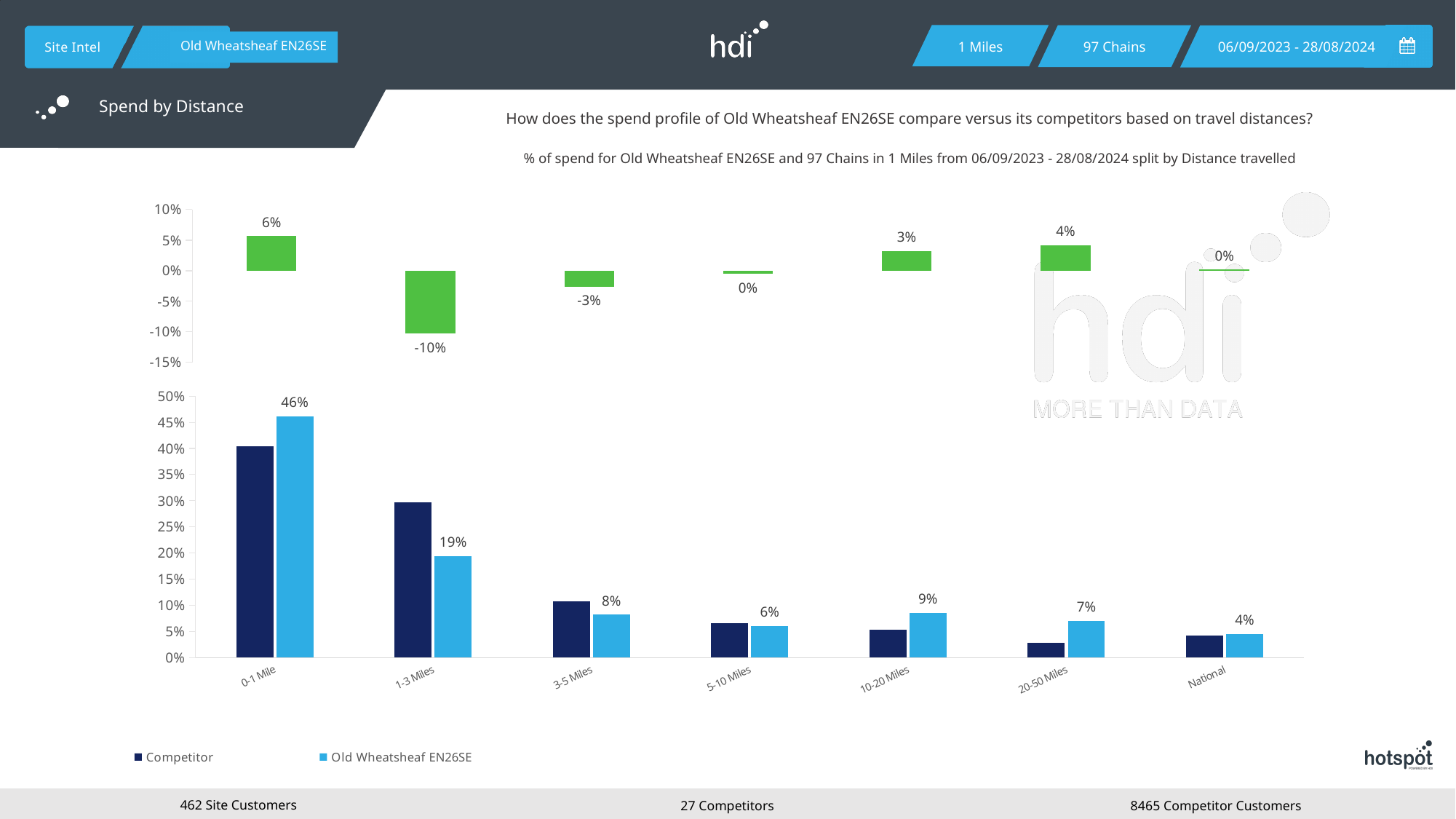
In the bottom chart, which is larger for 1-3 Miles: the Competitor value or the Old Wheatsheaf EN26SE value? Competitor In the bottom chart, what is the value for Old Wheatsheaf EN26SE in the 0-1 Mile category? 46% How many series does the legend of the bottom chart list? 2 In the bottom chart, is the Competitor value for 1-3 Miles greater or less than 25%? greater In the top chart, what is the value shown for the 20-50 Miles category? 4% In the top chart, what is the value shown for the 1-3 Miles category? -10% In the bottom chart, what is the difference between the Old Wheatsheaf EN26SE values for 0-1 Mile and 1-3 Miles? 27% In the top chart, which category has the lowest value? 1-3 Miles In the bottom chart, what is the value for Old Wheatsheaf EN26SE in the 10-20 Miles category? 9% How many categories are shown on the x axis of the bottom chart? 7 In the bottom chart, which category has the highest value for Old Wheatsheaf EN26SE? 0-1 Mile In the bottom chart, what is the value for Old Wheatsheaf EN26SE in the 1-3 Miles category? 19%